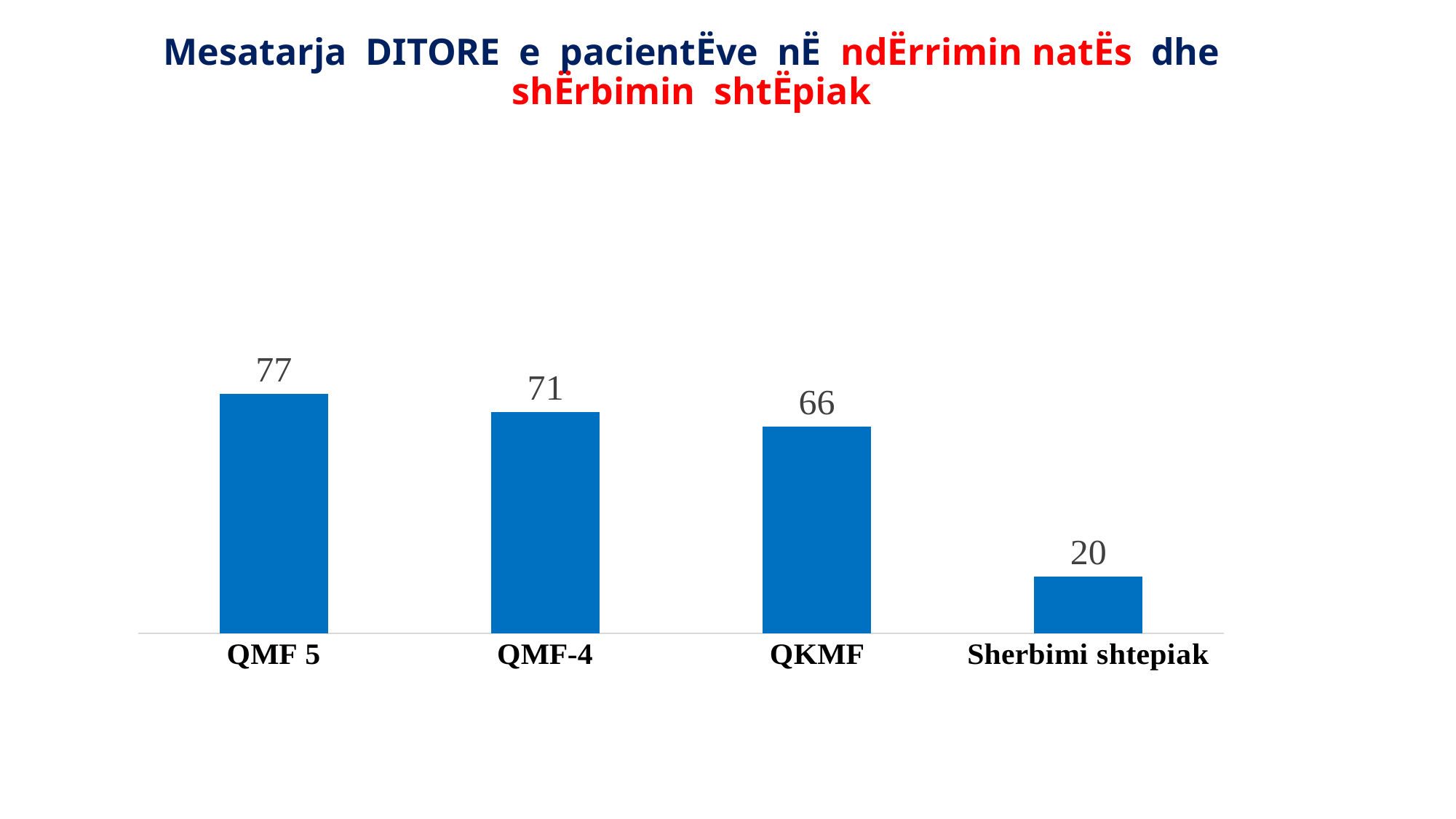
What kind of chart is shown on the slide? Bar chart Which is larger, the value for QMF-4 or the value for QKMF? QMF-4 What is the difference between the values for QMF-4 and QKMF? 5 How many categories are shown in the chart? 4 Do the values rise or fall from left to right along the x axis? Fall What is the value for QKMF? 66 Which category has the lowest value? Sherbimi shtepiak What is the value for QMF-4? 71 What is the value for QMF 5? 77 What is the value for Sherbimi shtepiak? 20 Which category has the highest value? QMF 5 What is the difference between the values for QMF 5 and Sherbimi shtepiak? 57